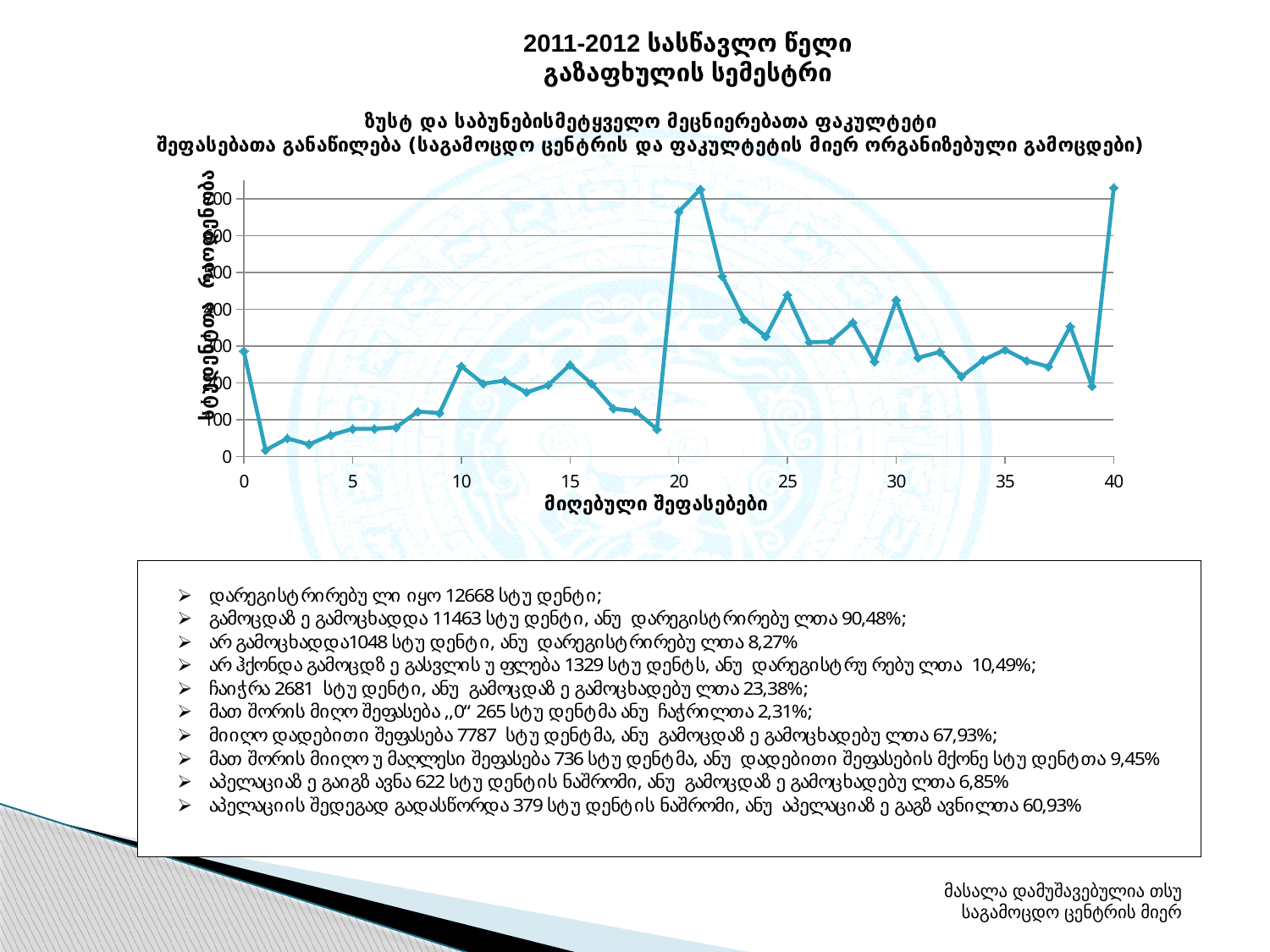
What is the label of the x axis? მიღებული შეფასებები Is the number of students for score 10 greater or less than 200? greater Is the number of students for score 19 greater or less than 100? less Does the number of students rise or fall between score 21 and score 22? fall Which score has more students, 0 or 10? 0 Is the number of students for score 21 greater or less than 600? greater What kind of chart is shown on the slide? line chart Which score has more students, 19 or 20? 20